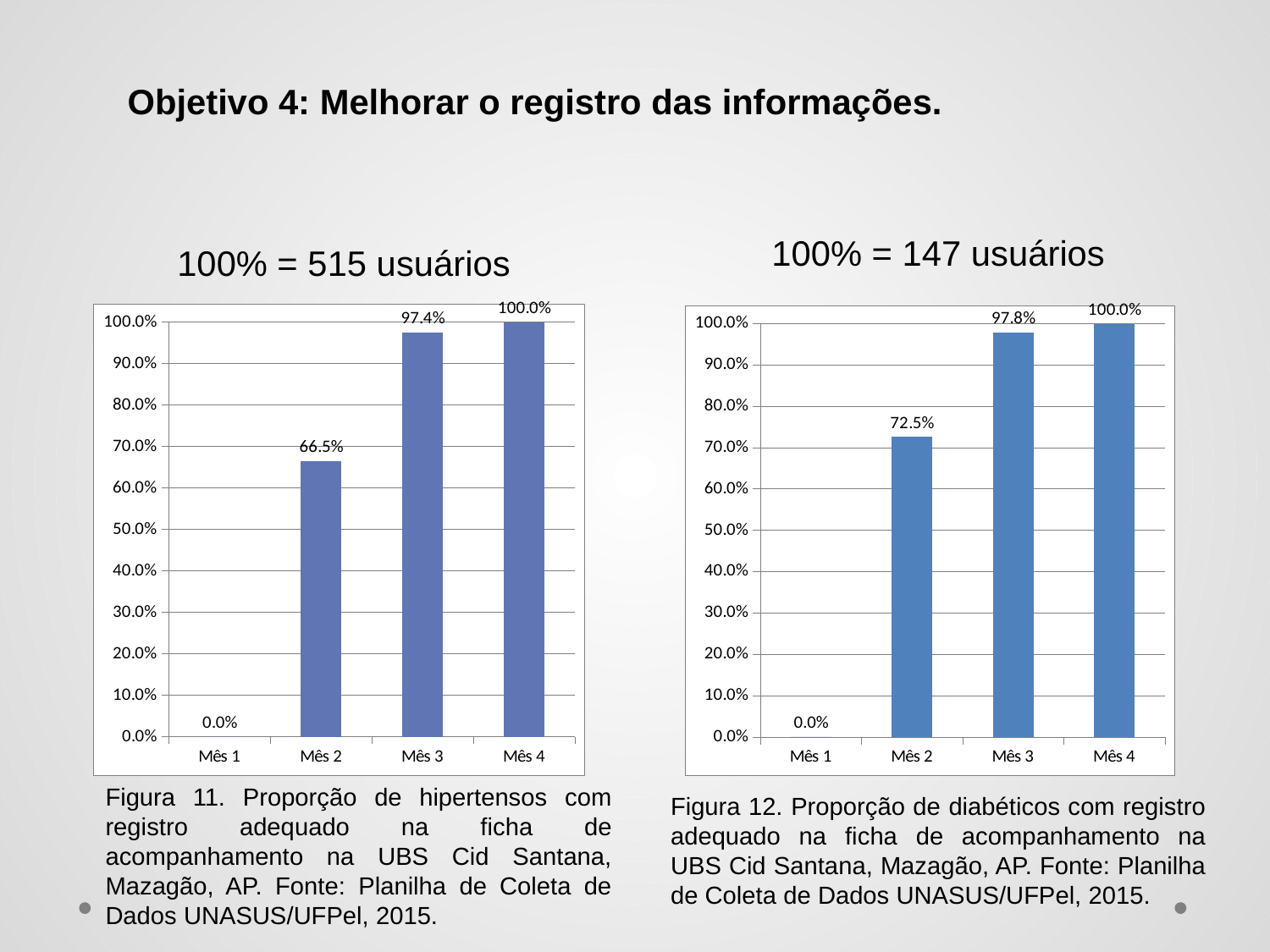
In the left chart (Figura 11, hipertensos), what is the value for Mês 3? 97.4% In the left chart (Figura 11, hipertensos), what is the value for Mês 2? 66.5% In the left chart (Figura 11, hipertensos), which month has the lowest value? Mês 1 In the right chart (Figura 12, diabéticos), do the values rise or fall from Mês 1 to Mês 4? Rise In the right chart (Figura 12, diabéticos), what is the difference between the values for Mês 4 and Mês 2? 27.5% In the right chart (Figura 12, diabéticos), what is the value for Mês 2? 72.5% How many months are shown on the x axis of the left chart (Figura 11)? 4 In the left chart (Figura 11, hipertensos), what is the difference between the values for Mês 3 and Mês 2? 30.9% Which is larger: the Mês 2 value in the left chart (hipertensos) or the Mês 2 value in the right chart (diabéticos)? The right chart (diabéticos), 72.5% What type of chart is used in Figura 12 (diabéticos)? Bar chart In the right chart (Figura 12, diabéticos), which month has the highest value? Mês 4 In the right chart (Figura 12, diabéticos), what is the value for Mês 3? 97.8%